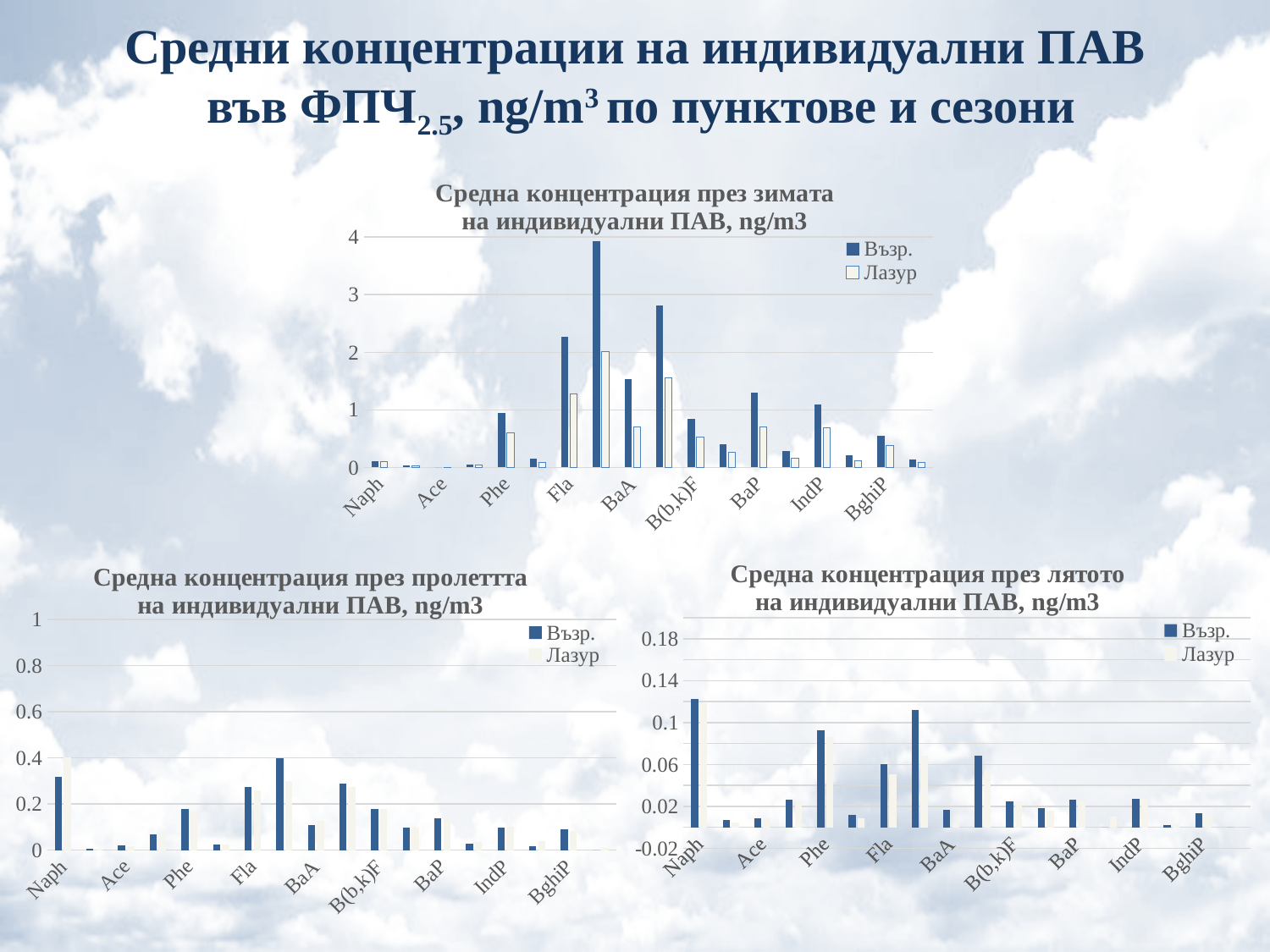
What kind of chart is the top chart titled 'Средна концентрация през зимата на индивидуални ПАВ, ng/m3'? bar chart What are the two series named in the legend of the spring chart (bottom left)? Възр. and Лазур In the winter chart (top), is the Възр. value for Phe greater or less than 2? less In the winter chart (top), which series has the larger value for BaA, Възр. or Лазур? Възр. In the winter chart (top), which series has the larger value for Fla, Възр. or Лазур? Възр. How many series does the legend of the winter chart (top) list? 2 In the winter chart (top), is the Възр. value for Fla greater or less than 2? greater In the winter chart (top), is the Възр. value for BaA greater or less than 1? greater